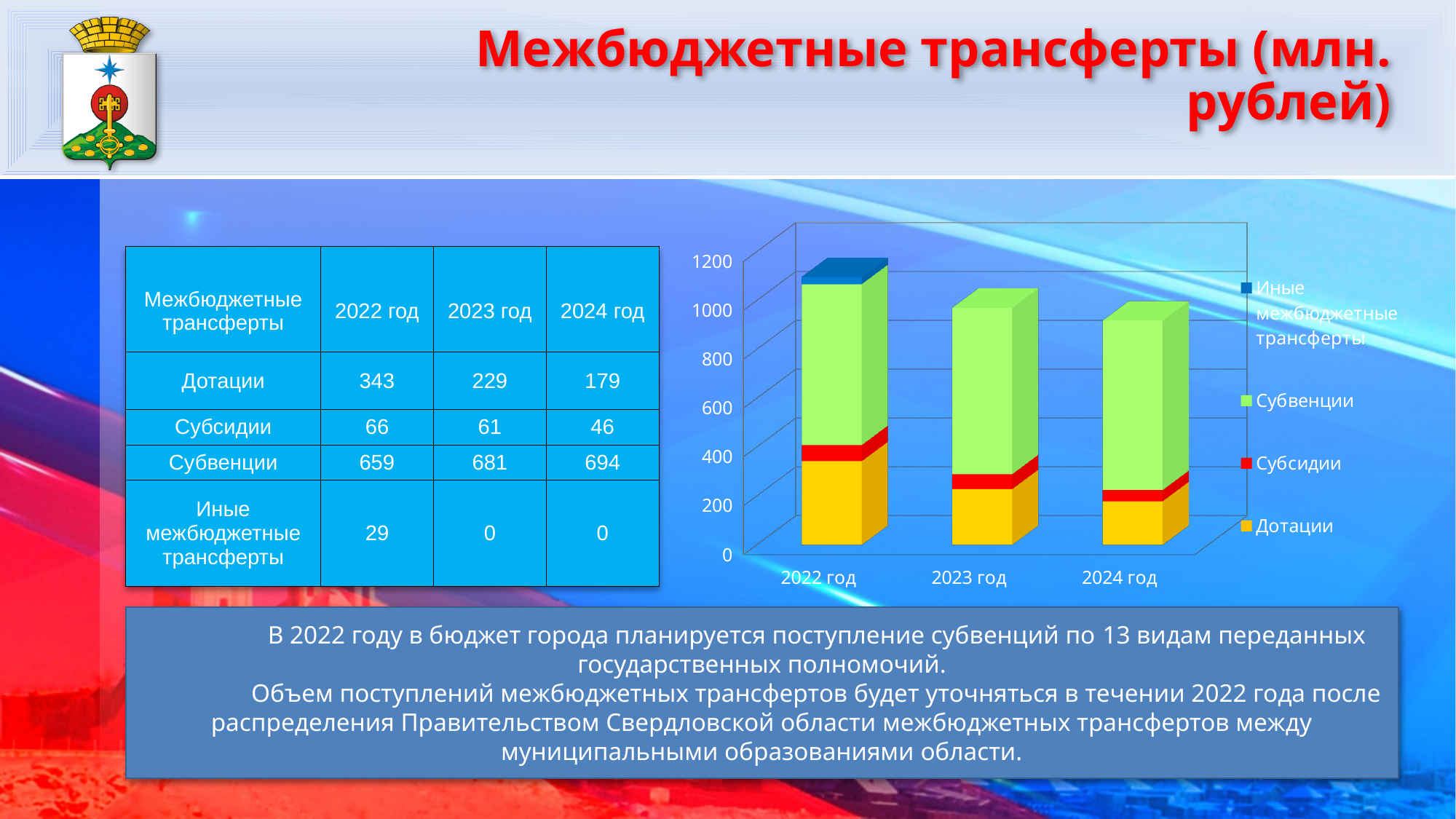
Which year has the lowest total stacked bar? 2024 год What is the value of Субвенции for 2024 год? 694 Is the total stacked bar for 2024 год greater or less than 1000? less What is the value of Иные межбюджетные трансферты for 2023 год? 0 What is the total of the stacked bar for 2022 год? 1097 Do the total stacked bar values rise or fall from 2022 год to 2024 год? fall What is the value of Дотации for 2022 год? 343 Which year has the highest total stacked bar? 2022 год What is the difference between Дотации in 2022 год and 2024 год? 164 How many series does the chart legend list? 4 How many years (categories) are shown on the x axis of the chart? 3 What kind of chart is shown on the slide? stacked bar chart